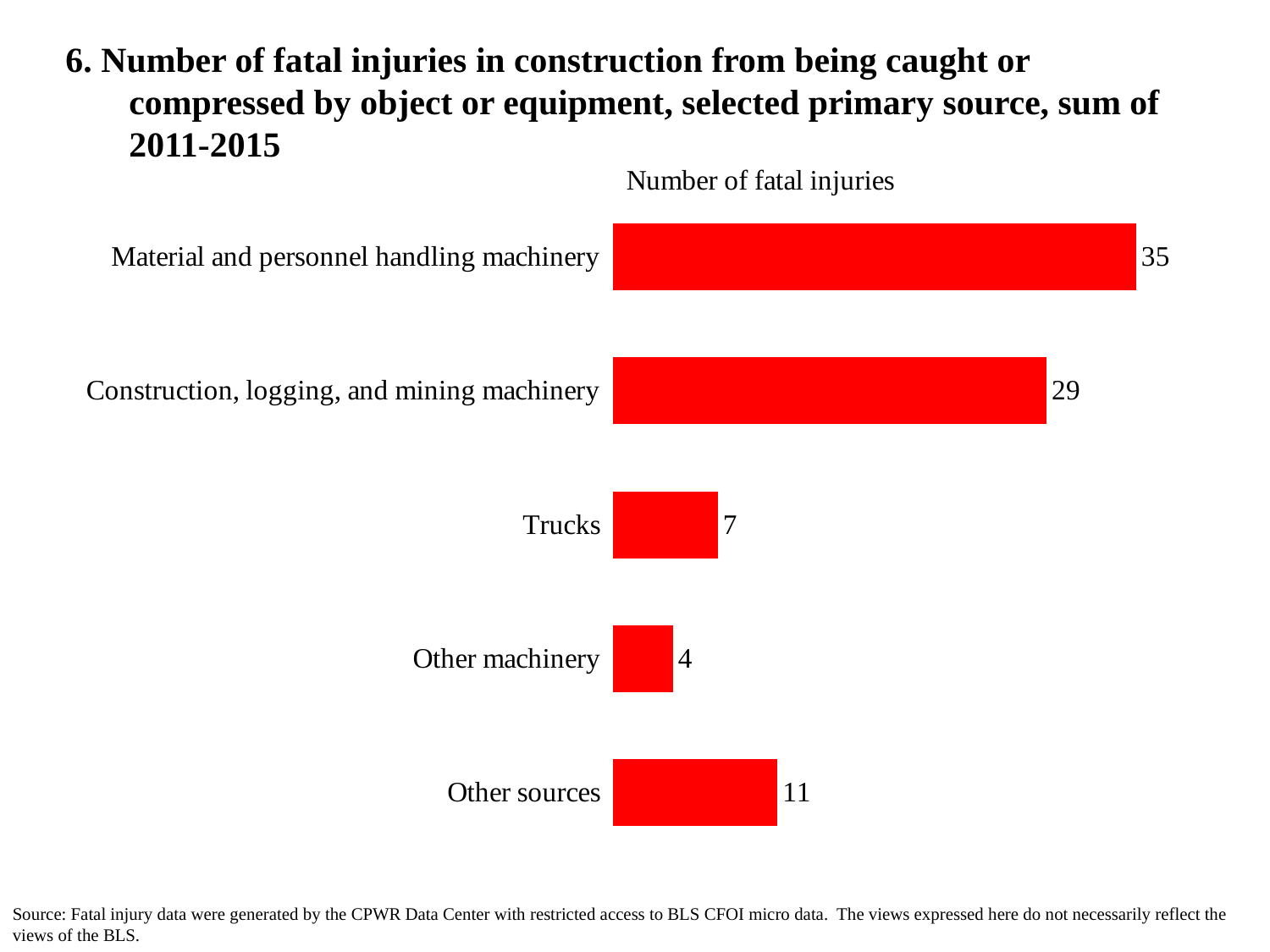
Which primary source has the highest number of fatal injuries? Material and personnel handling machinery Which has more fatal injuries, Trucks or Other sources? Other sources What is the number of fatal injuries for Material and personnel handling machinery? 35 What is the number of fatal injuries for Construction, logging, and mining machinery? 29 What is the number of fatal injuries for Trucks? 7 What is the difference in fatal injuries between Material and personnel handling machinery and Construction, logging, and mining machinery? 6 Which primary source has the lowest number of fatal injuries? Other machinery How many primary source categories are shown in the chart? 5 What type of chart is shown on the slide? Bar chart What is the axis title shown above the bars? Number of fatal injuries What is the number of fatal injuries for Other sources? 11 What is the number of fatal injuries for Other machinery? 4